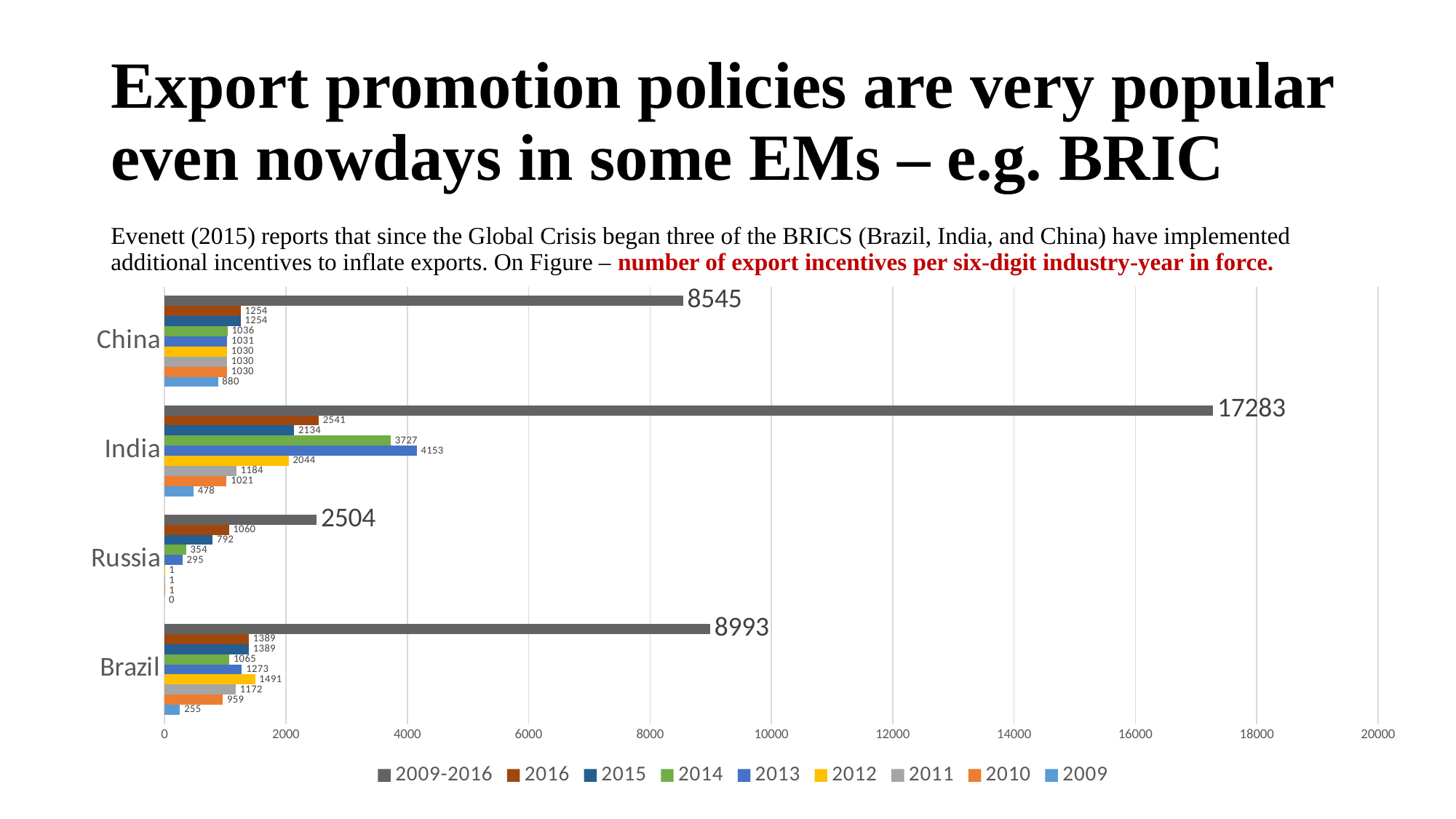
What is the 2009-2016 value for India? 17283 Which country has the highest 2009-2016 value? India What is the difference between the 2009-2016 values for Brazil and China? 448 What type of chart is shown on the slide? bar chart Which country has the lowest 2009-2016 value? Russia What is the 2009-2016 value for Russia? 2504 Which is larger, the 2014 value for India or the 2014 value for Brazil? India What is the 2013 value for India? 4153 How many series does the legend list? 9 Is the 2009-2016 value for India greater or less than 16000? greater How many countries are shown on the chart? 4 What is the 2012 value for Brazil? 1491